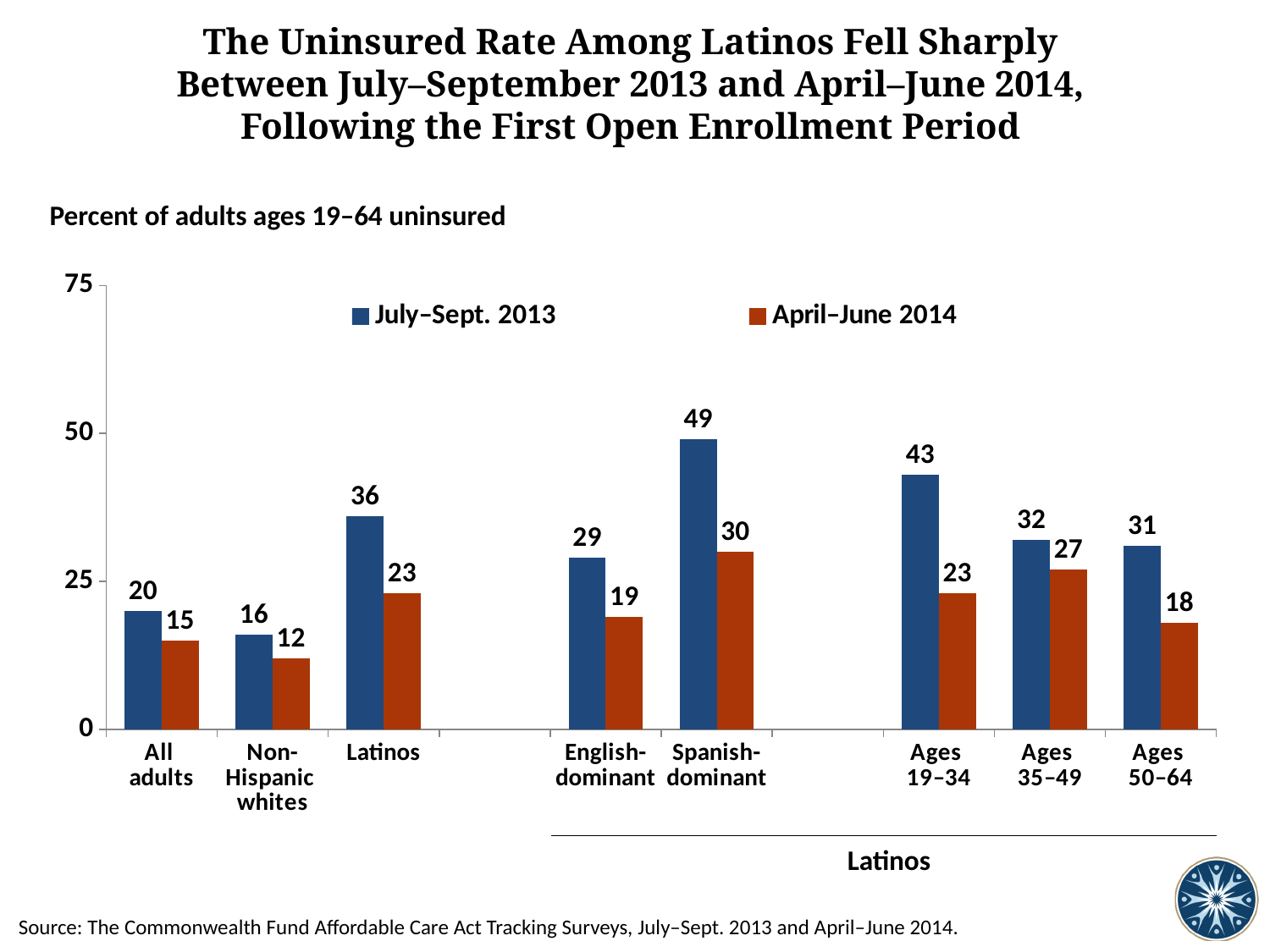
What is the difference between the July–Sept. 2013 values for Latinos and All adults? 16 How many series does the legend list? 2 What is the April–June 2014 uninsured rate for Spanish-dominant Latinos? 30 Which category has the lowest April–June 2014 uninsured rate? Non-Hispanic whites Which is larger: the April–June 2014 value for Ages 35–49 or for Ages 50–64? Ages 35–49 What is the April–June 2014 value for Non-Hispanic whites? 12 Is the July–Sept. 2013 value for Spanish-dominant Latinos greater or less than 50? less Which category has the highest July–Sept. 2013 uninsured rate? Spanish-dominant How many categories are shown on the x axis? 8 By how many percentage points did the uninsured rate for Latinos ages 19–34 fall between July–Sept. 2013 and April–June 2014? 20 What is the July–Sept. 2013 uninsured rate for Latinos? 36 What kind of chart is shown on the slide? bar chart